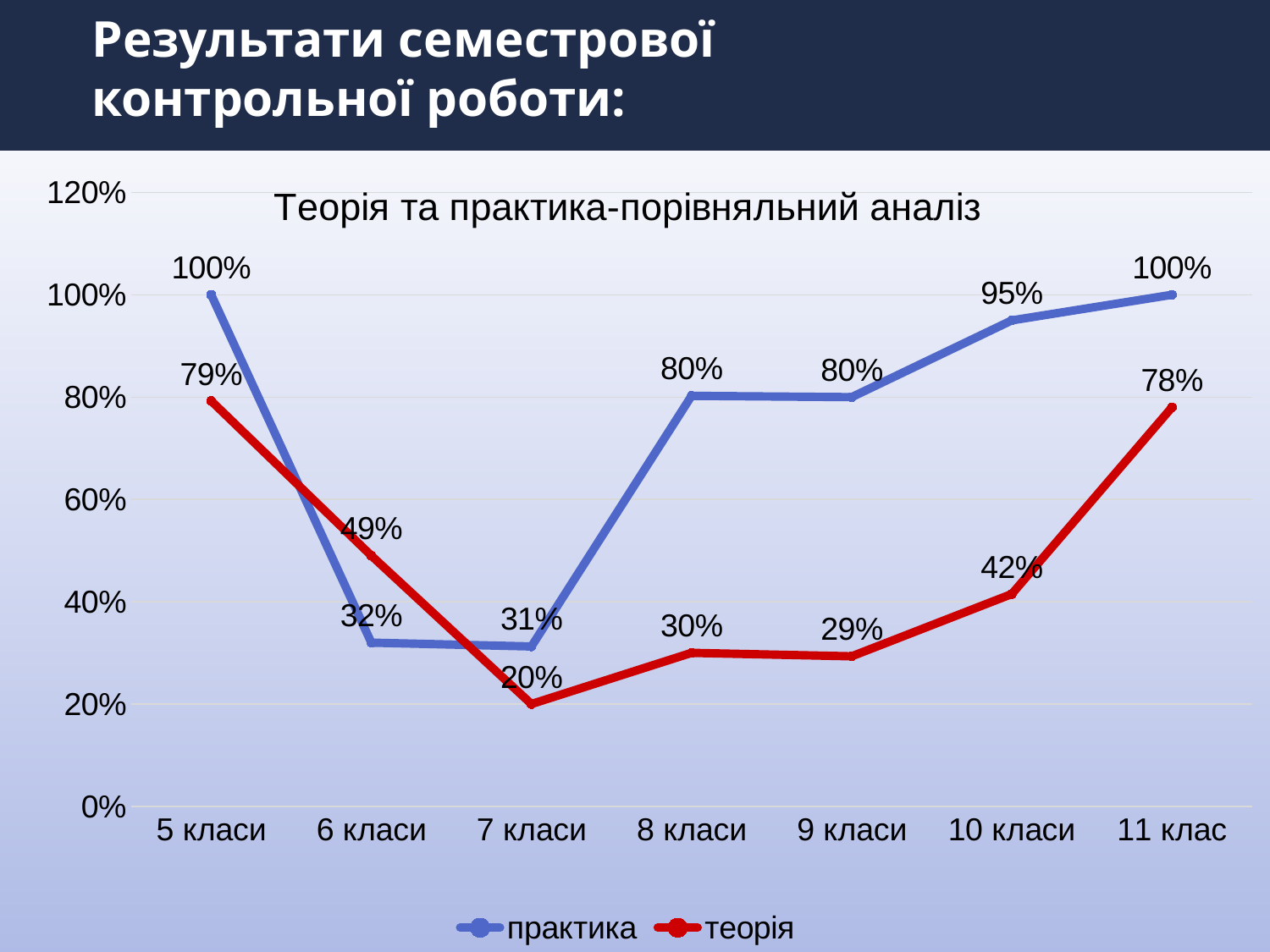
What type of chart is shown on the slide? line chart What is the value of теорія for 10 класи? 42% How many categories are shown on the x axis? 7 What is the value of теорія for 7 класи? 20% Does the теорія series rise or fall from 7 класи to 11 клас? rise Which category has the lowest value for практика? 7 класи How many series does the legend list? 2 Which is larger for 6 класи, практика or теорія? теорія What is the title of the chart? Теорія та практика-порівняльний аналіз What is the value of практика for 8 класи? 80% Which category has the lowest value for теорія? 7 класи What is the difference between практика and теорія for 9 класи? 51%